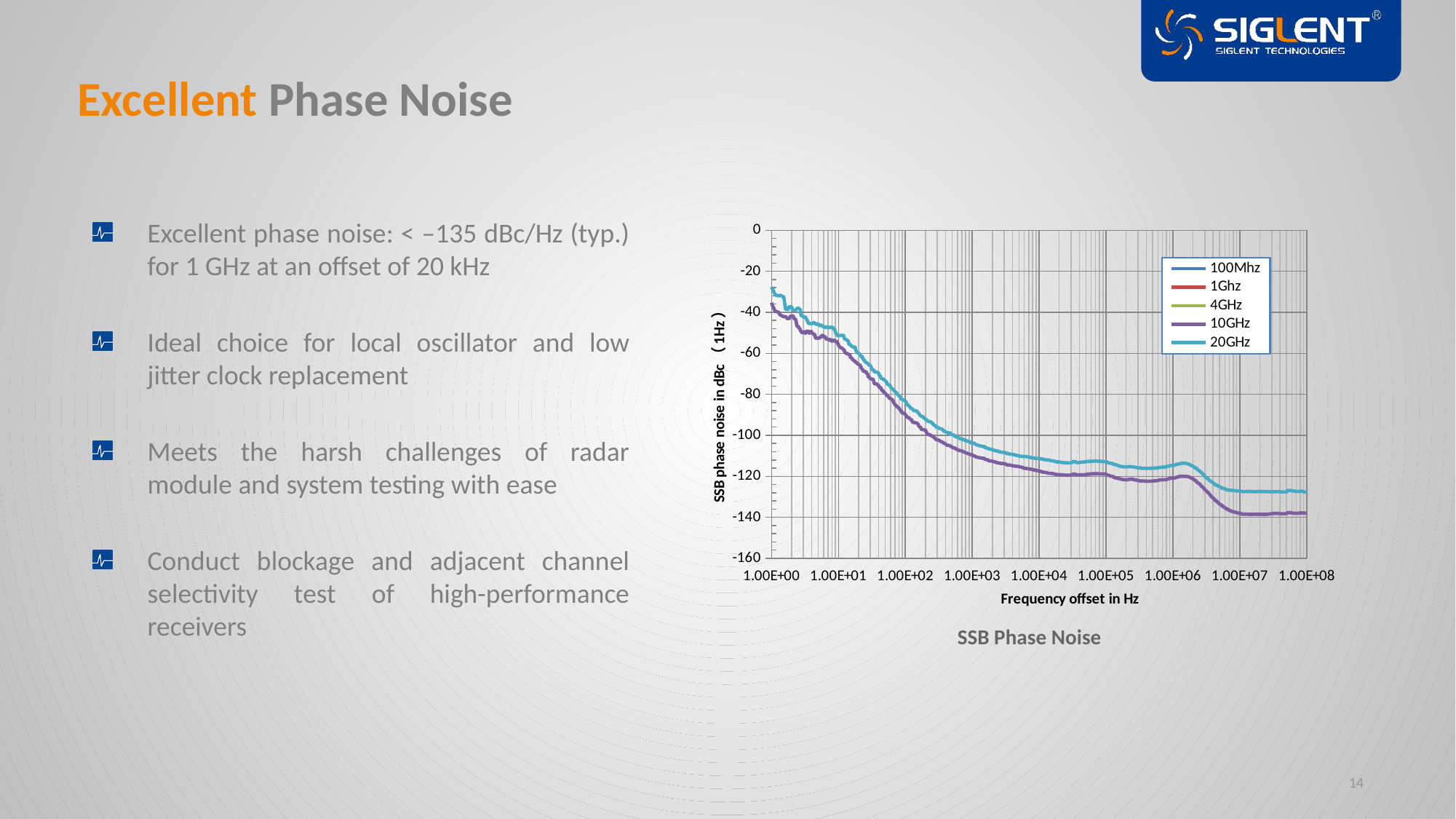
Is the value of the 20GHz series at 1.00E+00 Hz greater or less than -40? greater Is the value of the 10GHz series at 1.00E+03 Hz greater or less than -100? less What is the title of the chart? SSB Phase Noise How many series does the legend of the SSB Phase Noise chart list? 5 Is the value of the 20GHz series at 1.00E+08 Hz greater or less than -140? greater Do the plotted values rise or fall as the frequency offset increases along the x axis? fall Which of the visible series has the lowest phase noise values across the chart? 10GHz What kind of chart is shown on the slide? line chart What is the label of the x axis of the chart? Frequency offset in Hz At 1.00E+04 Hz, which series has the higher value, 10GHz or 20GHz? 20GHz How many tick labels are shown on the x axis of the chart? 9